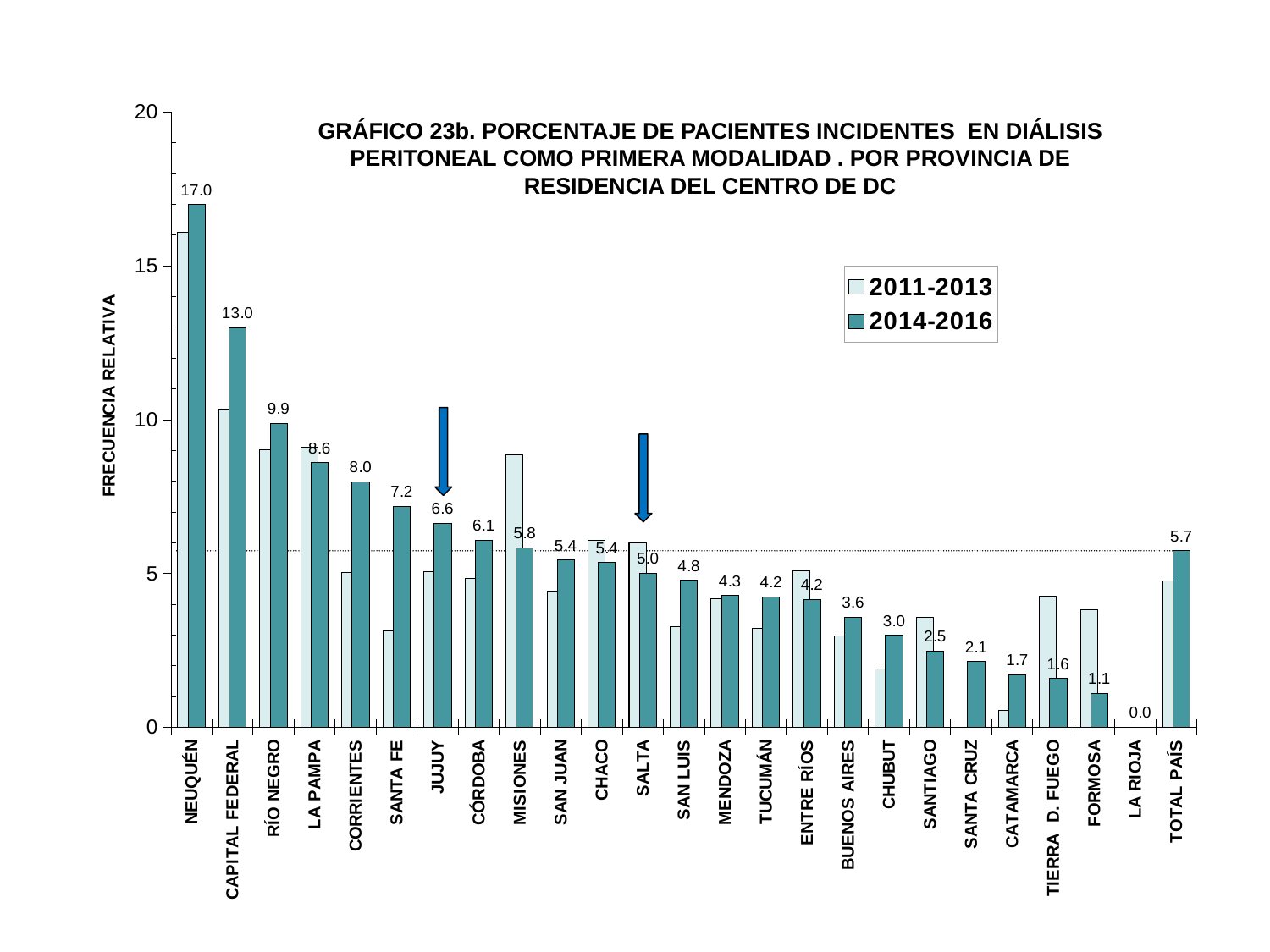
Which province has the lowest value in the 2014-2016 series? LA RIOJA What is the difference between the 2014-2016 values for NEUQUÉN and CAPITAL FEDERAL? 4.0 For MISIONES, which series has the larger value, 2011-2013 or 2014-2016? 2011-2013 Do the 2014-2016 values rise or fall from NEUQUÉN to LA RIOJA along the x axis? Fall What is the value for CAPITAL FEDERAL in the 2014-2016 series? 13.0 What is the value for TOTAL PAÍS in the 2014-2016 series? 5.7 How many categories are shown on the x axis? 25 How many series does the legend list? 2 What is the value for SALTA in the 2014-2016 series? 5.0 Which province has the highest value in the 2014-2016 series? NEUQUÉN Is the 2011-2013 value for NEUQUÉN greater or less than 15? greater What kind of chart is shown on the slide? Bar chart